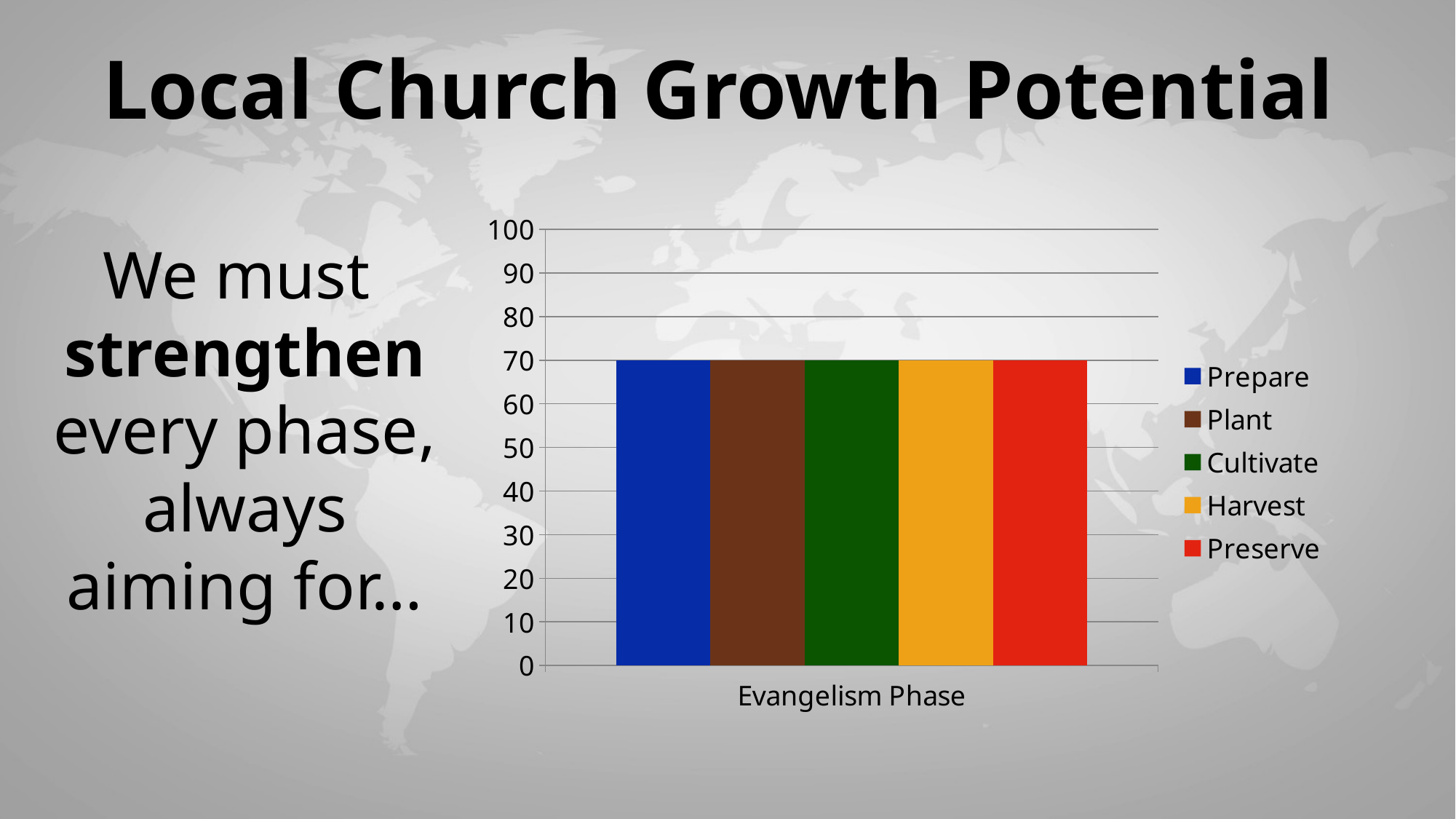
Which legend entry is shown in green? Cultivate What is the label of the category on the x axis? Evangelism Phase Is the value for Cultivate greater or less than 90? less What is the value of the Prepare bar? 70 Is the value for Preserve greater or less than 50? greater What is the value of the Harvest bar? 70 What is the value of the Cultivate bar? 70 What kind of chart is shown on the slide? bar chart How many series does the legend list? 5 What is the value of the Plant bar? 70 How many categories are shown on the x axis? 1 What is the value of the Preserve bar? 70